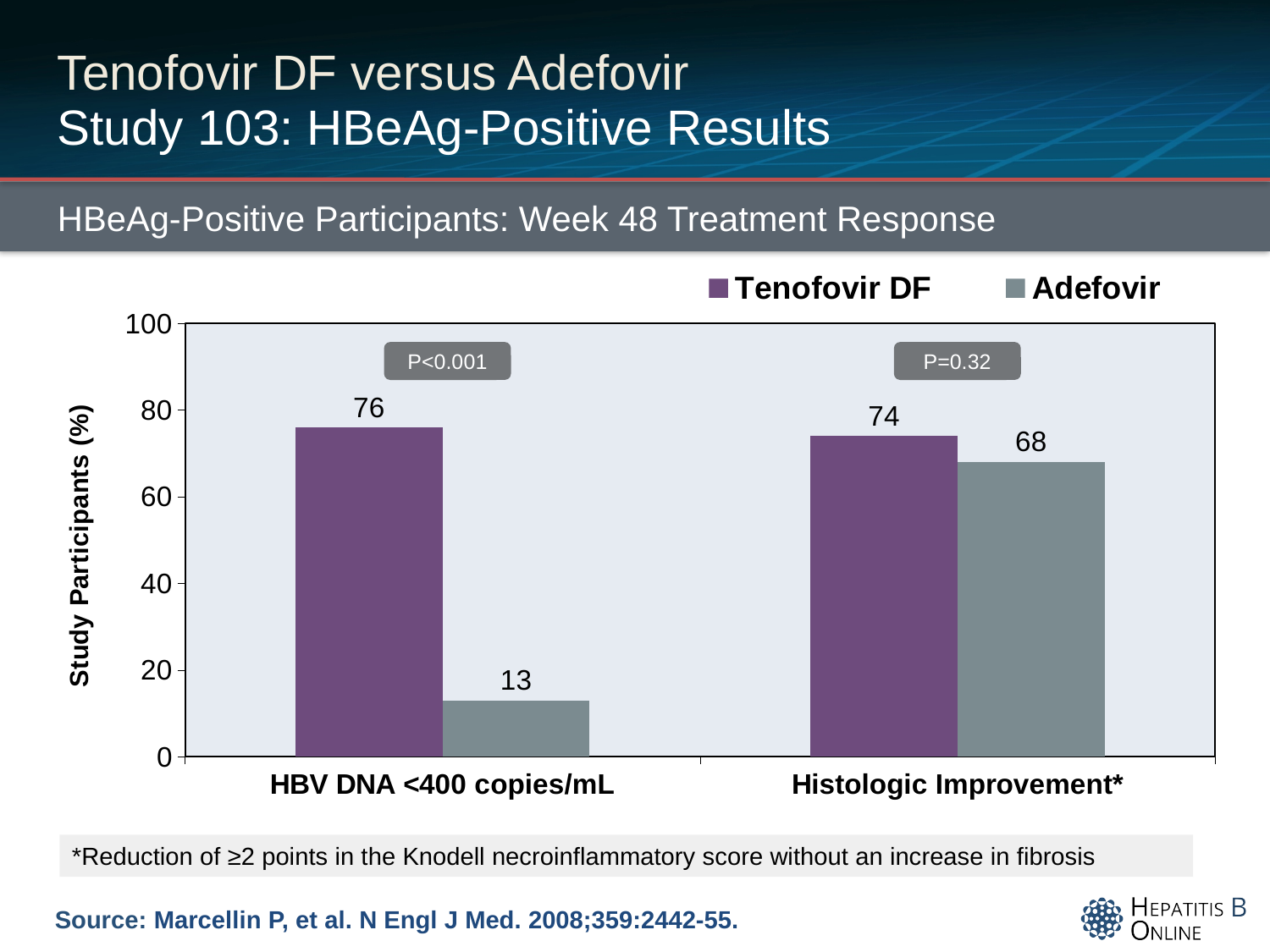
How many categories are shown on the x axis? 2 Which bar has the lowest value on the chart? Adefovir, HBV DNA <400 copies/mL What is the value for Tenofovir DF in the Histologic Improvement* category? 74 Which is larger in the Histologic Improvement* category, Tenofovir DF or Adefovir? Tenofovir DF What kind of chart is shown on the slide? Bar chart What is the difference between Tenofovir DF and Adefovir in the HBV DNA <400 copies/mL category? 63 What is the difference between Tenofovir DF and Adefovir in the Histologic Improvement* category? 6 What is the value for Tenofovir DF in the HBV DNA <400 copies/mL category? 76 What is the value for Adefovir in the Histologic Improvement* category? 68 How many series does the legend list? 2 Which bar has the highest value on the chart? Tenofovir DF, HBV DNA <400 copies/mL What is the value for Adefovir in the HBV DNA <400 copies/mL category? 13